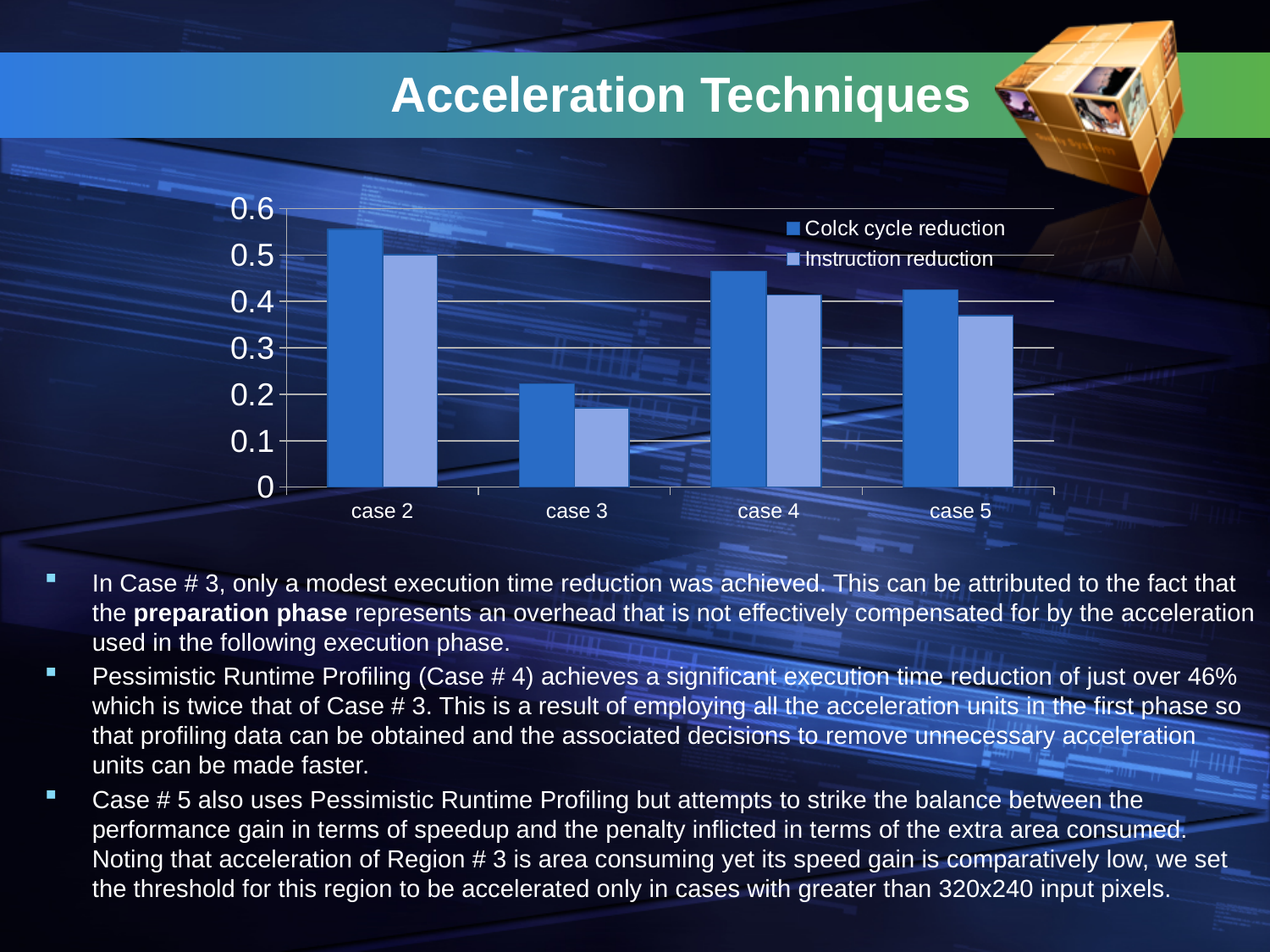
What are the two series named in the chart's legend? Colck cycle reduction and Instruction reduction Is the Colck cycle reduction for case 2 greater or less than 0.5? greater How many series does the chart's legend list? 2 What kind of chart is shown on the slide? bar chart Is the Instruction reduction for case 5 greater or less than 0.4? less Which case has the highest Colck cycle reduction? case 2 For case 2, which is larger, the Colck cycle reduction or the Instruction reduction? Colck cycle reduction How many cases are shown on the x axis of the chart? 4 Which has the larger Colck cycle reduction, case 4 or case 5? case 4 Is the Colck cycle reduction for case 3 greater or less than 0.3? less Which case has the lowest Colck cycle reduction? case 3 Which case has the lowest Instruction reduction? case 3